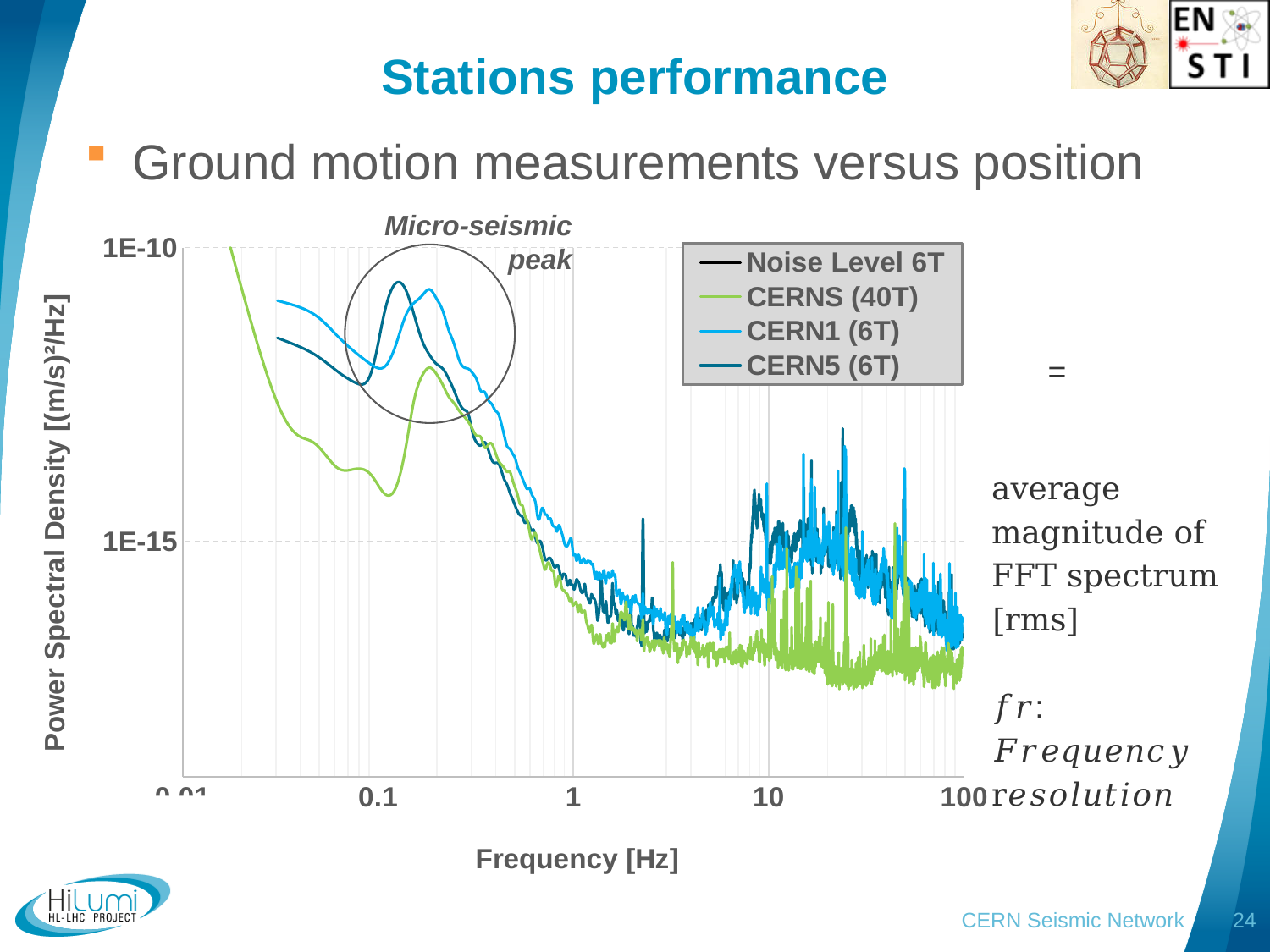
Is the value for CERN1 (6T) at 0.1 Hz greater or less than 1E-15? greater At 0.1 Hz, which series has the higher value, CERN1 (6T) or CERNS (40T)? CERN1 (6T) How many series does the legend list? 4 Does the CERNS (40T) series generally rise or fall as frequency increases from 0.01 Hz to 1 Hz? fall At 10 Hz, which series has the higher value, CERN1 (6T) or CERNS (40T)? CERN1 (6T) Which series has the lowest values between 10 Hz and 100 Hz? CERNS (40T) Is the value for CERNS (40T) at 10 Hz greater or less than 1E-15? less Is the value for CERN1 (6T) at 0.1 Hz greater or less than 1E-10? less What kind of chart is shown on the slide? line chart What feature is circled and annotated near the top of the chart? Micro-seismic peak What is the label of the x axis? Frequency [Hz]